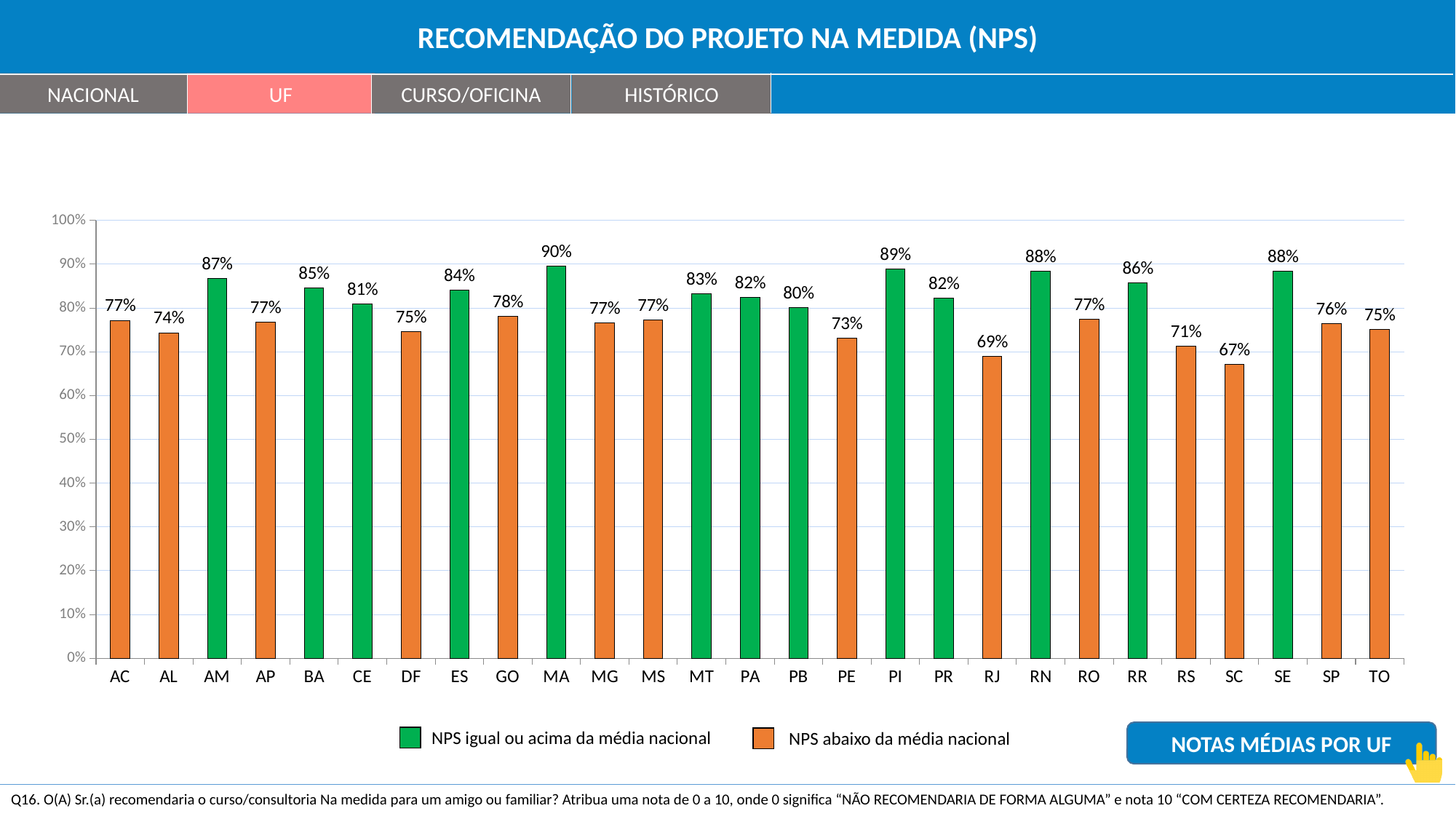
What is the difference between the NPS of MA and SC? 23% How many entries does the legend list? 2 Which UF has the highest NPS? MA What colour are the bars for UFs with NPS equal to or above the national average? green Which UF has the lowest NPS? SC What is the NPS value for MA? 90% Is the value for RS greater or less than 80%? less What kind of chart is shown on the slide? bar chart What is the NPS value for RJ? 69% What is the NPS value for PI? 89% Which has a higher NPS, BA or CE? BA How many UFs are shown on the x axis? 27